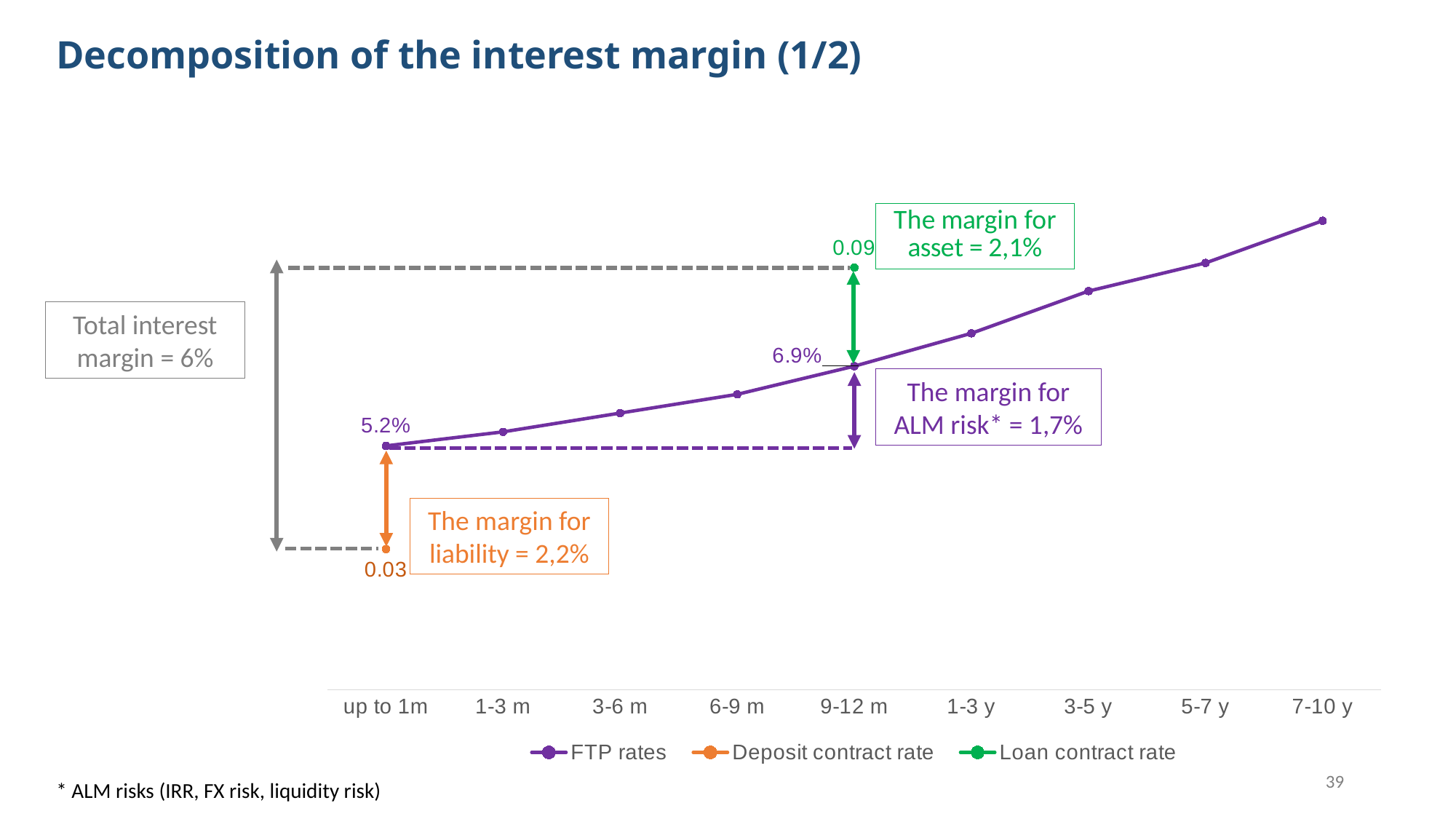
What is the FTP rate for the 'up to 1m' bucket? 5.2% At which maturity bucket is the FTP rate highest? 7-10 y Which is larger, the FTP rate at '9-12 m' or at 'up to 1m'? 9-12 m What is the title of the slide? Decomposition of the interest margin (1/2) Do the FTP rates rise or fall as maturity increases along the x axis? rise How many maturity buckets are shown on the x axis? 9 What value is labelled for the Loan contract rate point? 0.09 What is the FTP rate for the '9-12 m' bucket? 6.9% How many series does the legend list? 3 What value is labelled for the Deposit contract rate point? 0.03 What is the difference between the FTP rate at '9-12 m' and at 'up to 1m'? 1.7% What kind of chart is shown on the slide? line chart